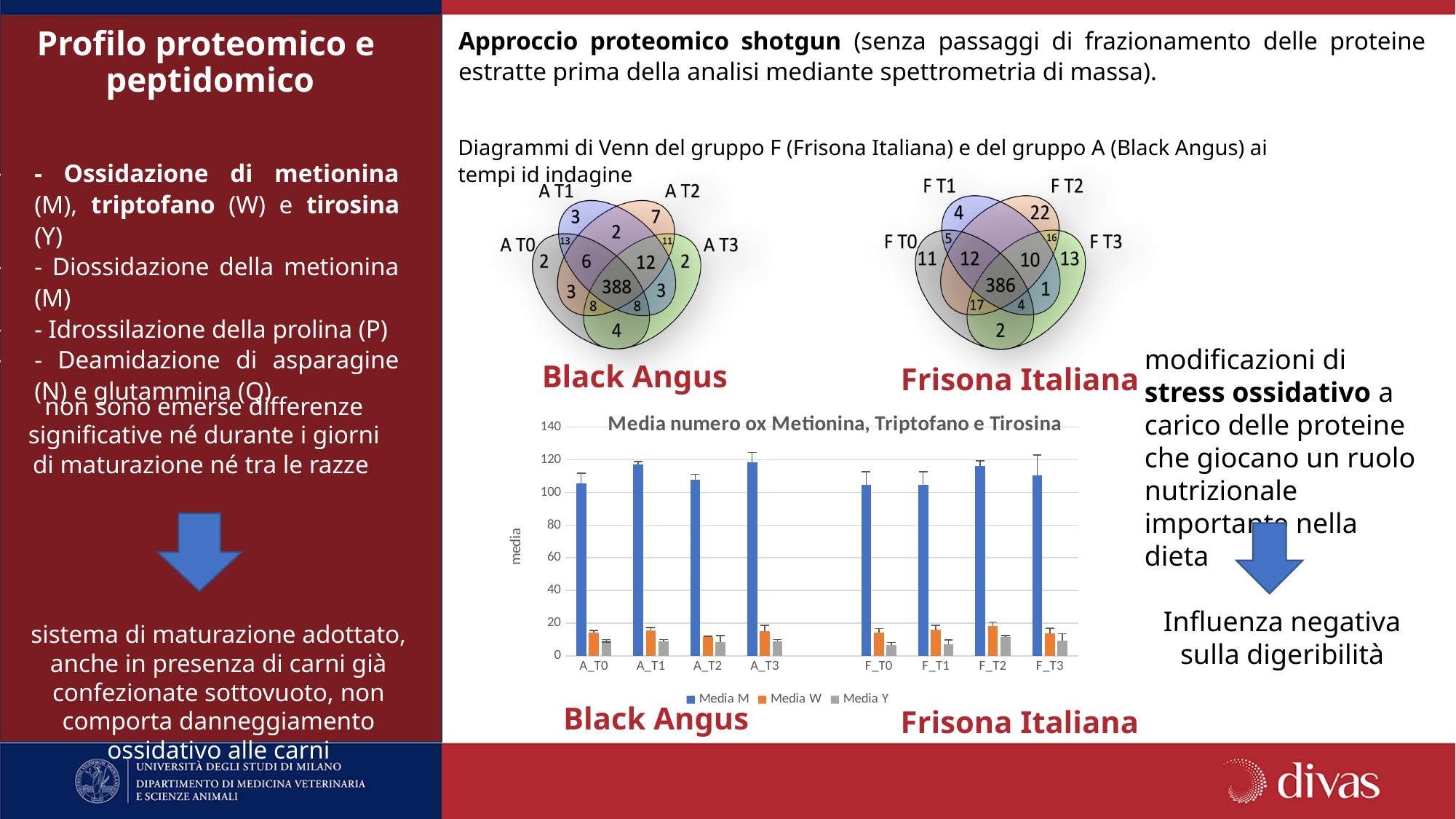
In the bar chart, is the Media M value for A_T0 greater or less than 100? greater In the bar chart, which is larger for F_T1: Media M or Media W? Media M What are the legend entries of the bar chart? Media M, Media W, Media Y How many categories are shown on the x axis of the bar chart? 8 In the bar chart, is the Media M value for A_T1 greater or less than 120? less In the bar chart, is the Media W value for F_T2 greater or less than 20? less In the bar chart, which is larger for A_T1: Media W or Media Y? Media W In the Black Angus Venn diagram, what number is in the central region shared by all four groups? 388 How many series does the legend of the bar chart list? 3 What is the label on the vertical axis of the bar chart? media What kind of chart is the chart titled "Media numero ox Metionina, Triptofano e Tirosina"? bar chart